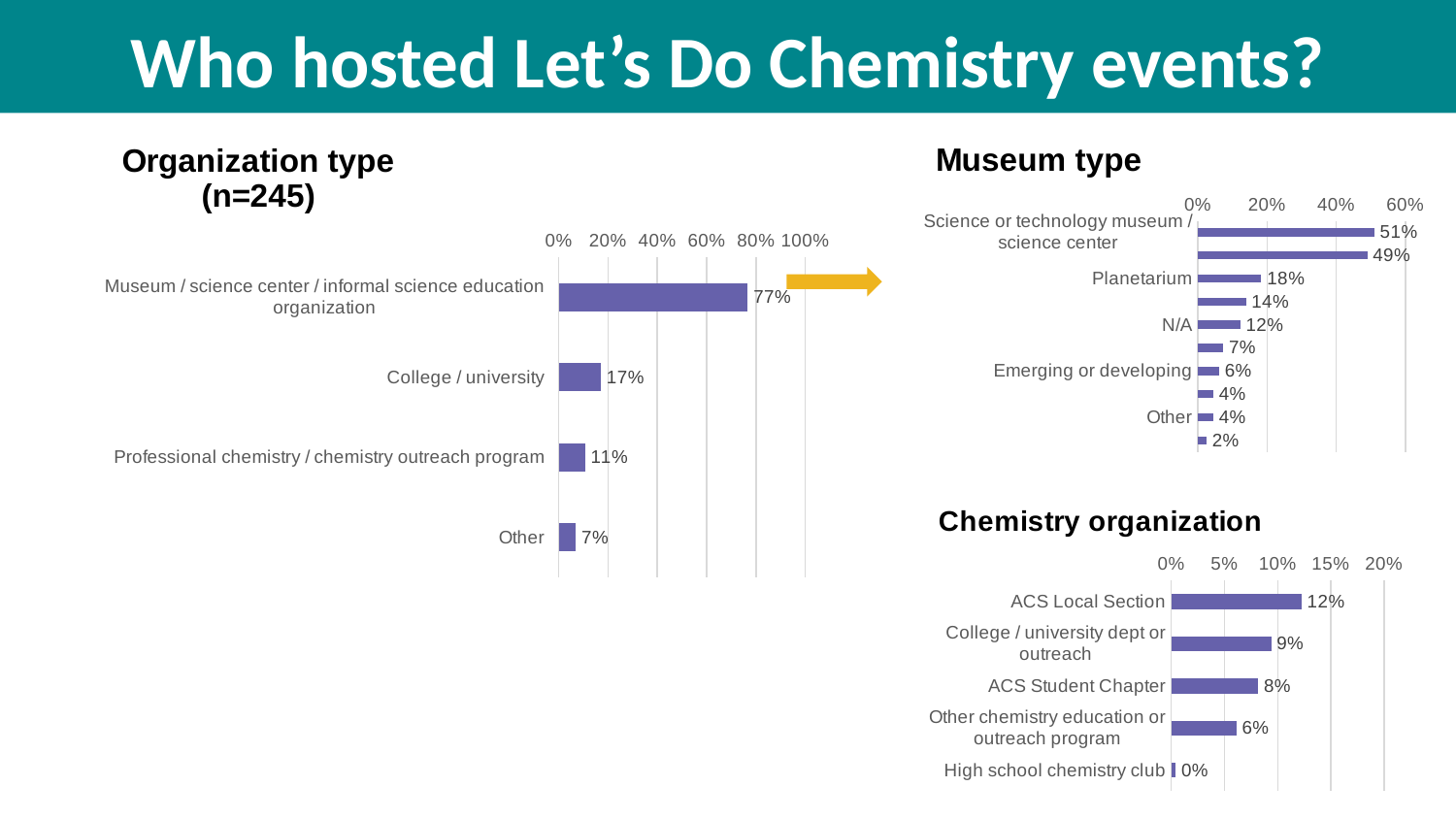
In the Chemistry organization chart, what percentage is shown for ACS Student Chapter? 8% In the Museum type chart, which is larger: the value for N/A or the value for Emerging or developing? N/A In the Chemistry organization chart, which category has the lowest value? High school chemistry club What sample size is given in the title of the Organization type chart? n=245 In the Museum type chart, what percentage is shown for Planetarium? 18% In the Organization type chart, what percentage is shown for College / university? 17% In the Organization type chart, which category has the highest value? Museum / science center / informal science education organization In the Chemistry organization chart, what is the difference between ACS Local Section and College / university dept or outreach? 3% How many categories are shown in the Organization type chart? 4 In the Organization type chart, what is the difference between the Museum / science center / informal science education organization value and the Other value? 70% In the Museum type chart, what is the value labelled for Science or technology museum / science center? 51% What kind of chart is the Organization type chart? Bar chart